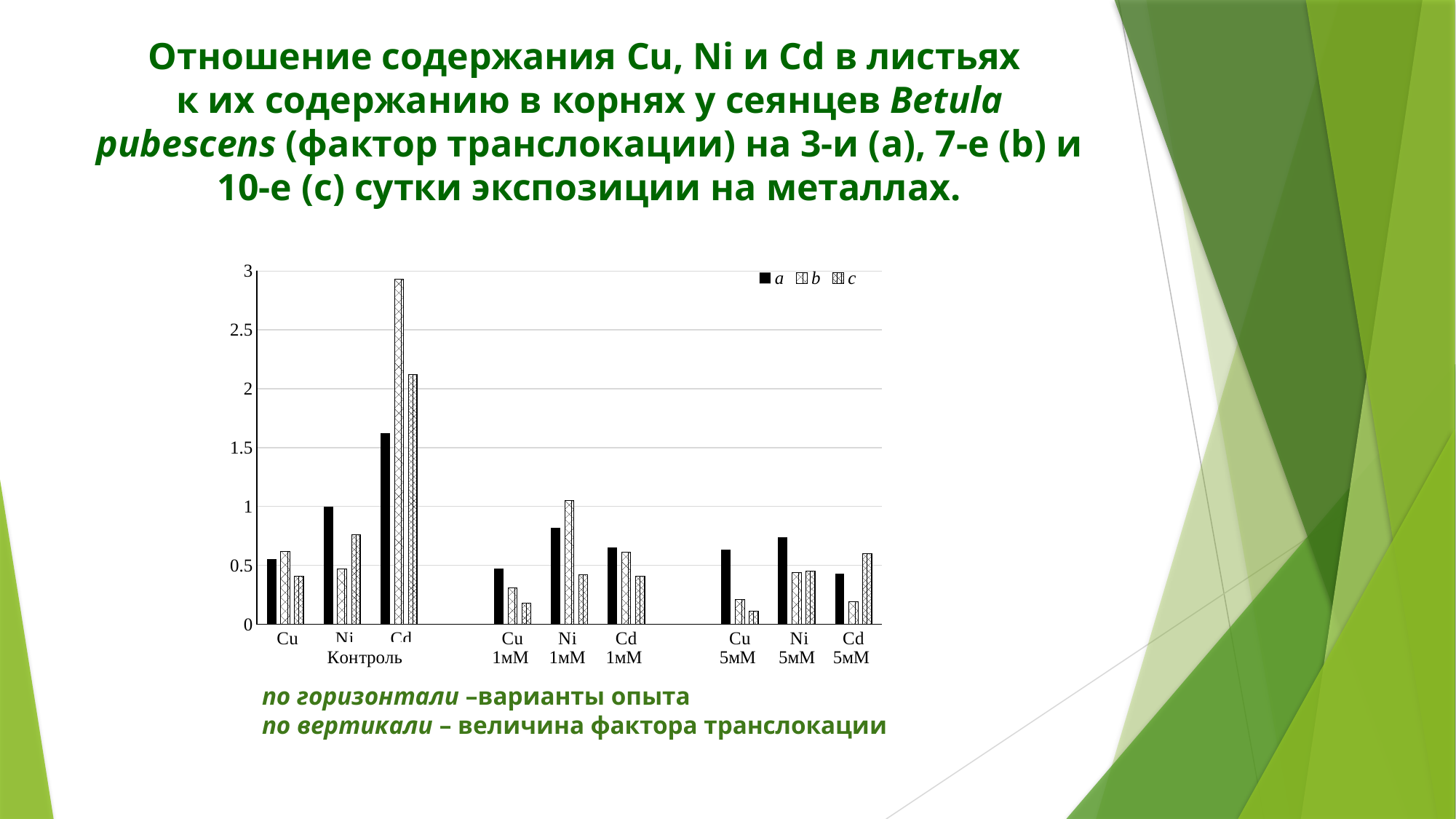
How many categories are shown along the x axis? 9 Is the value of series a for Cu 5мМ greater or less than 1? less How many series does the legend list? 3 For Cd (Контроль), which series has the larger value, b or c? b For Cu 5мМ, which series has the lowest value? c What kind of chart is shown on the slide? bar chart Is the value of series b for Cd (Контроль) greater or less than 2.5? greater Is the value of series c for Cd (Контроль) greater or less than 2? greater What are the entries listed in the chart legend? a, b, c For Ni 1мМ, which series has the larger value, a or b? b Which category and series has the highest bar in the chart? Cd (Контроль), series b